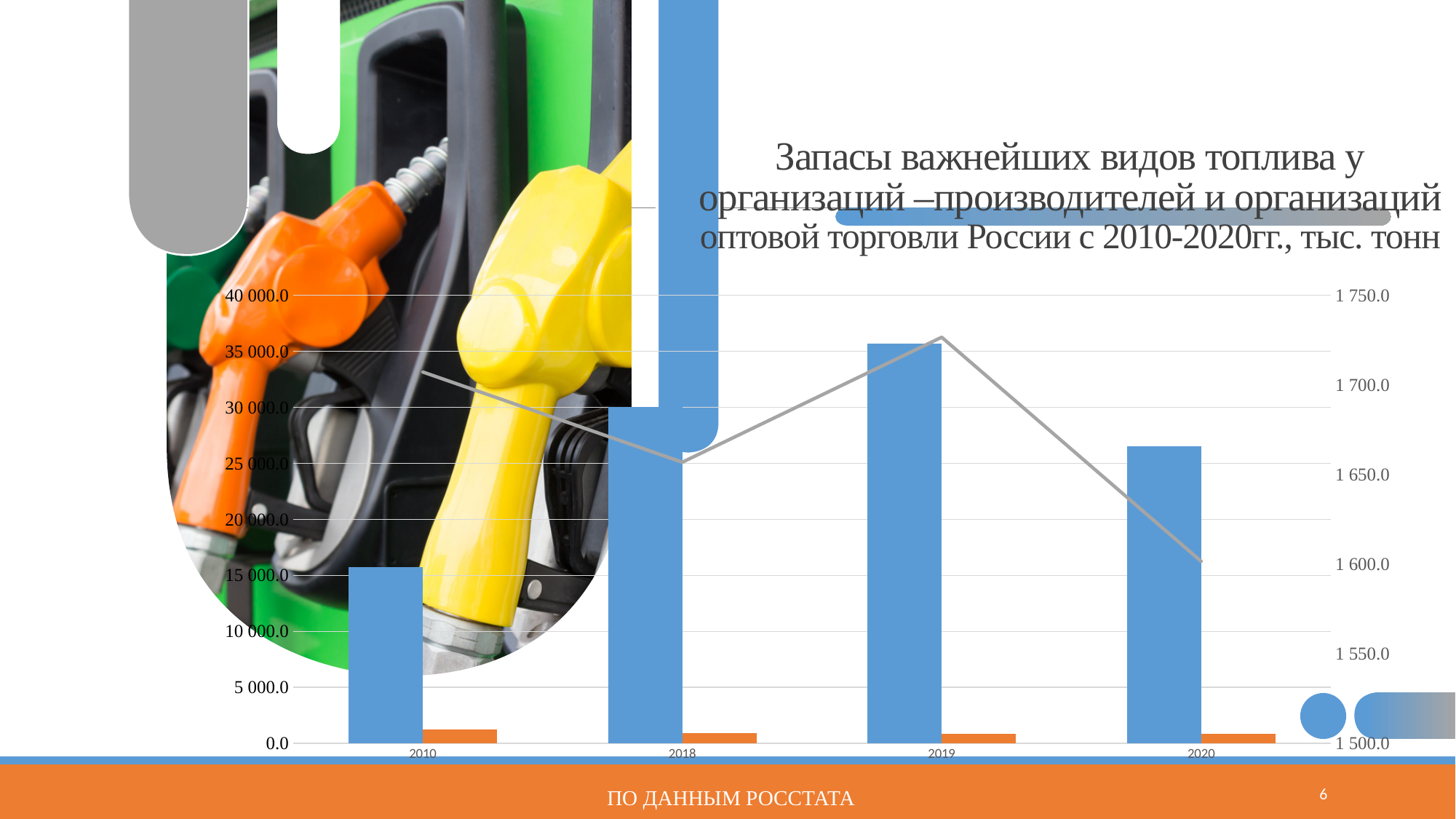
Is the blue bar for 2019 greater or less than 30 000.0? greater How many years are shown on the x axis of the chart? 4 Does the grey line rise or fall from 2019 to 2020? It falls Which blue bar is taller, 2018 or 2020? 2018 In which year does the grey line reach its lowest point? 2020 Which year has the shortest blue bar? 2010 Is the blue bar for 2018 greater or less than 25 000.0? greater Is the blue bar for 2010 greater or less than 20 000.0? less What kind of chart is shown on the slide? A combined bar and line chart Which year has the tallest blue bar? 2019